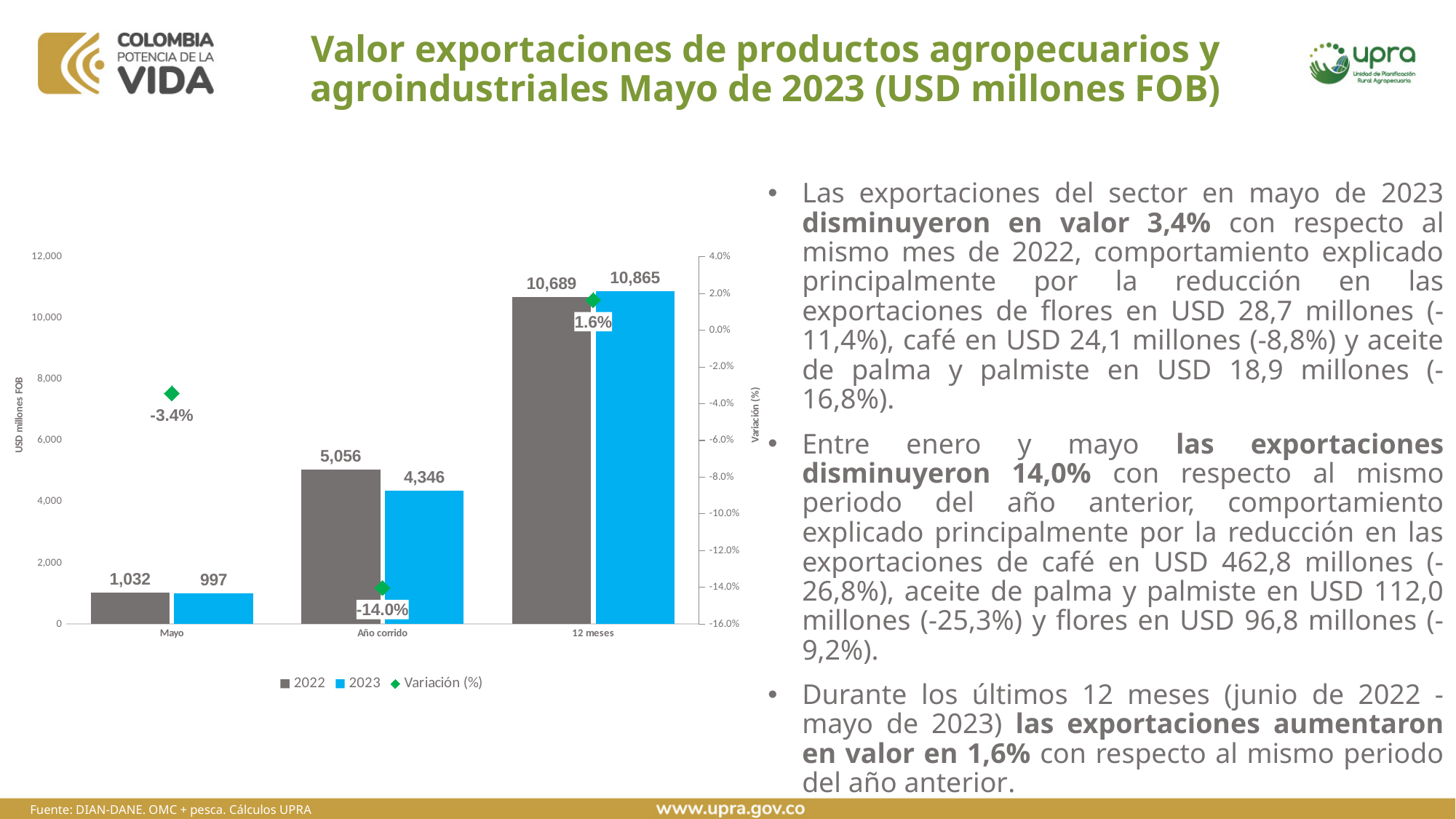
What is the Variación (%) value for 12 meses? 1.6% How many categories are shown on the x axis? 3 What is the Variación (%) value for Año corrido? -14.0% Which category has the lowest 2022 value? Mayo Which category has the highest 2023 value? 12 meses Which is larger for 12 meses, the 2022 value or the 2023 value? 2023 What is the label of the left vertical axis? USD millones FOB What is the difference between the 2022 and 2023 values for Año corrido? 710 What is the 2022 value for Mayo? 1,032 How many series does the legend list? 3 Is the 2023 value for Mayo greater or less than 2,000? less What is the 2023 value for Año corrido? 4,346